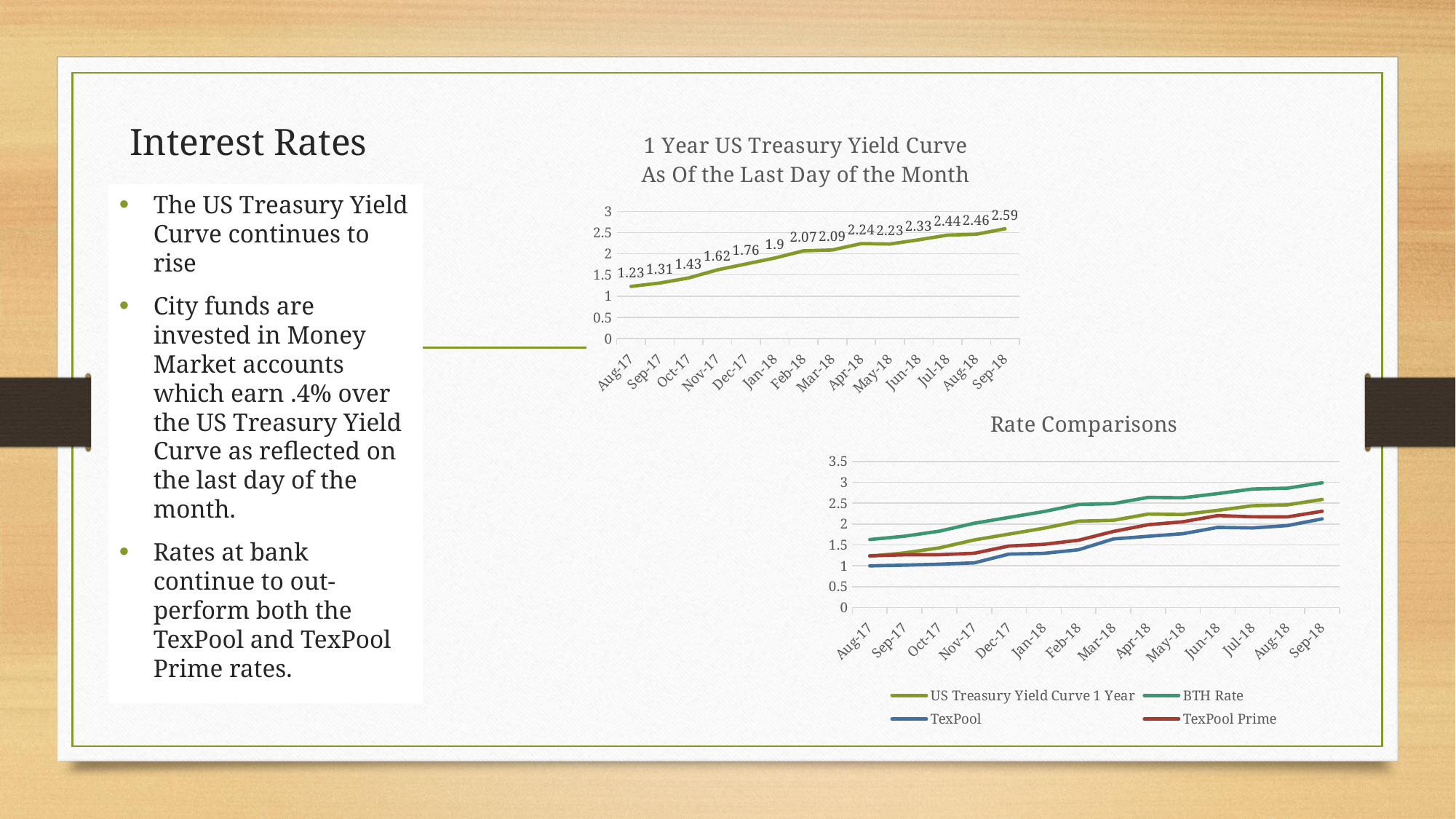
In the '1 Year US Treasury Yield Curve' chart, which is larger, the value for Apr-18 or May-18? Apr-18 What kind of chart is the 'Rate Comparisons' chart? line chart In the 'Rate Comparisons' chart, is the BTH Rate value for Sep-18 greater or less than 2.5? greater In the '1 Year US Treasury Yield Curve' chart, do the values generally rise or fall from Aug-17 to Sep-18? rise In the '1 Year US Treasury Yield Curve' chart, what is the value for Jan-18? 1.9 In the '1 Year US Treasury Yield Curve' chart, what is the value for Sep-18? 2.59 In the '1 Year US Treasury Yield Curve' chart, which month has the lowest value? Aug-17 In the '1 Year US Treasury Yield Curve' chart, what is the value for Aug-17? 1.23 In the '1 Year US Treasury Yield Curve' chart, what is the difference between the Sep-18 and Aug-17 values? 1.36 How many months are plotted in the '1 Year US Treasury Yield Curve' chart? 14 How many series does the legend of the 'Rate Comparisons' chart list? 4 In the '1 Year US Treasury Yield Curve' chart, which month has the highest value? Sep-18